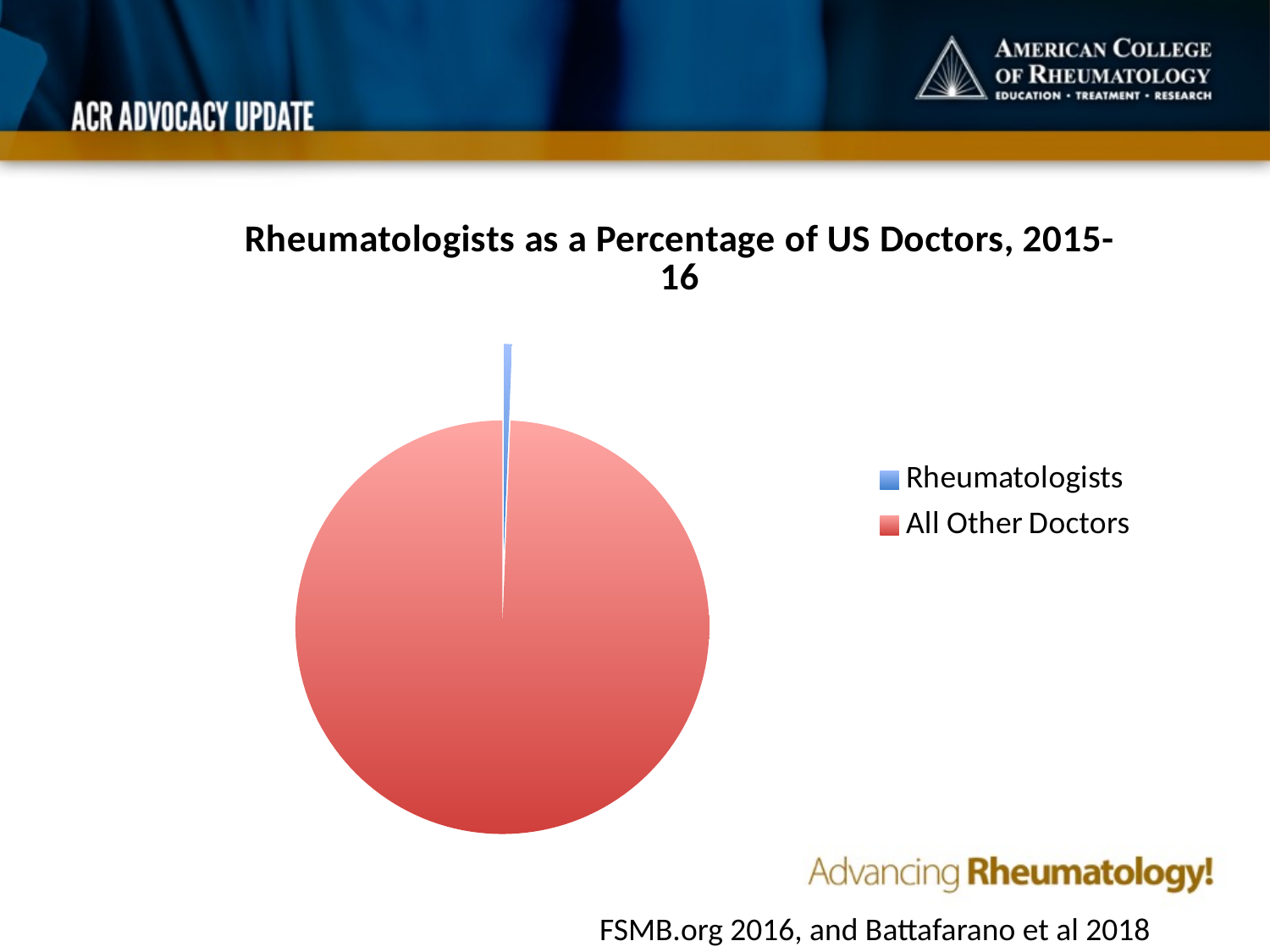
Which category has the largest slice of the pie? All Other Doctors How many slices does the pie chart have? 2 How many entries does the legend list? 2 Which slice is larger, Rheumatologists or All Other Doctors? All Other Doctors Which category has the smallest slice of the pie? Rheumatologists What kind of chart is shown on the slide? pie chart What is the title of the chart? Rheumatologists as a Percentage of US Doctors, 2015-16 What colour is the slice for Rheumatologists? blue